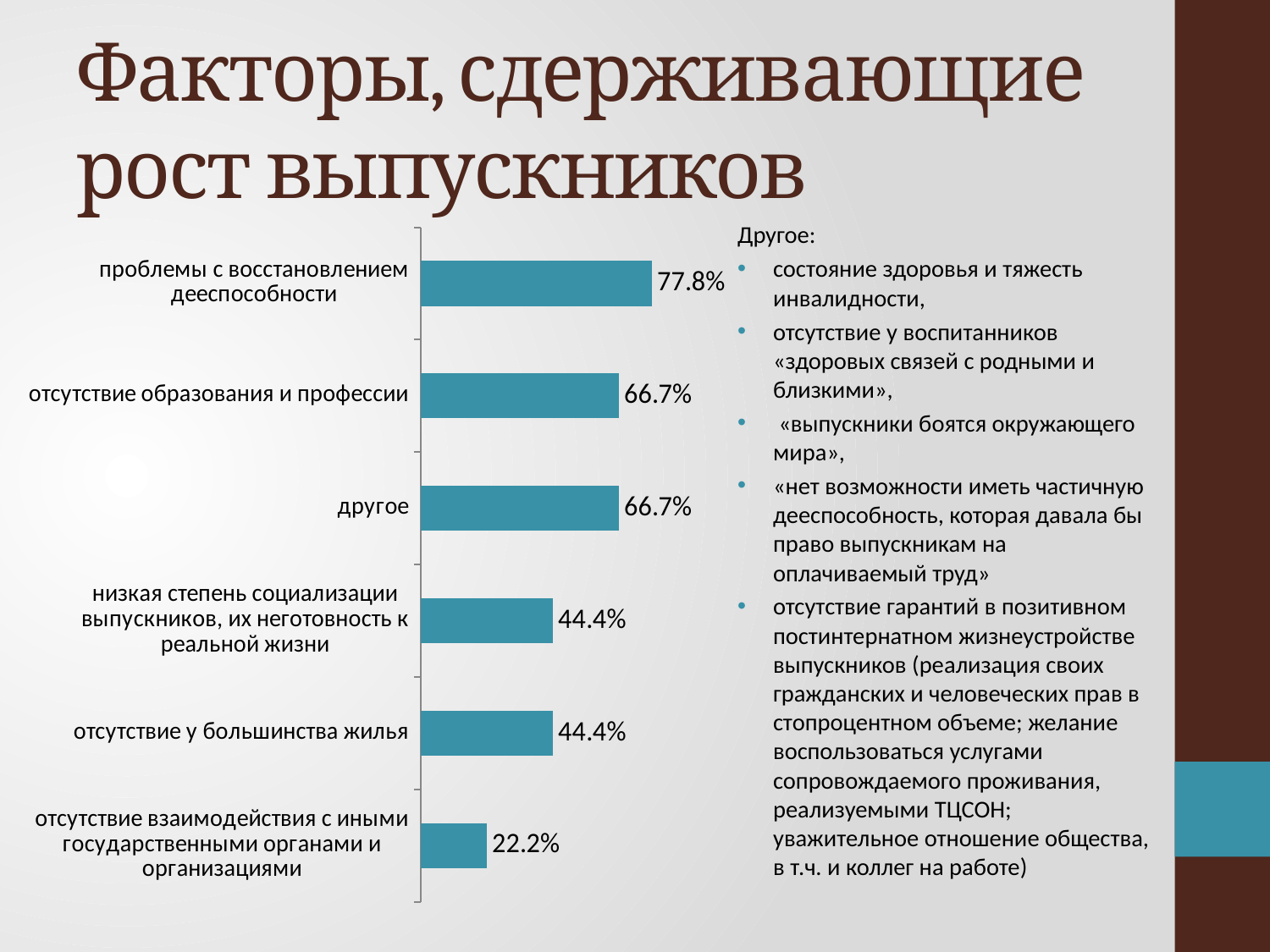
Which category has the lowest value? отсутствие взаимодействия с иными государственными органами и организациями What value is shown for «отсутствие взаимодействия с иными государственными органами и организациями»? 22.2% What value is shown for «отсутствие у большинства жилья»? 44.4% What value is shown for «отсутствие образования и профессии»? 66.7% Which is larger: the value for «низкая степень социализации выпускников, их неготовность к реальной жизни» or the value for «отсутствие взаимодействия с иными государственными органами и организациями»? низкая степень социализации выпускников, их неготовность к реальной жизни What is the difference between the values for «проблемы с восстановлением дееспособности» and «отсутствие образования и профессии»? 11.1% What kind of chart is shown on the slide? bar chart What is the title of the slide containing the chart? Факторы, сдерживающие рост выпускников Which category has the highest value? проблемы с восстановлением дееспособности What value is shown for «проблемы с восстановлением дееспособности»? 77.8% What is the difference between the values for «другое» and «отсутствие у большинства жилья»? 22.3% How many categories are shown in the chart? 6